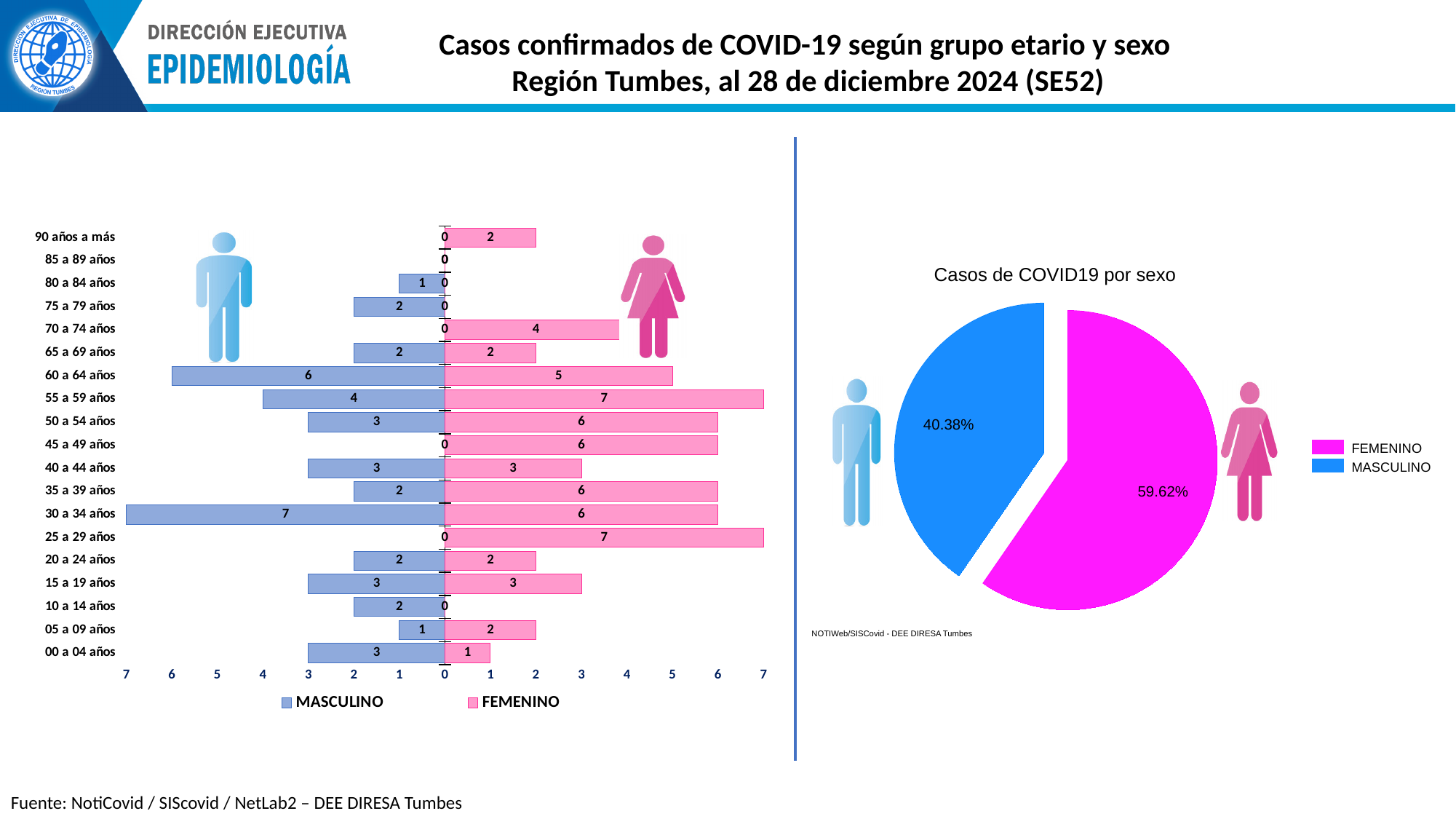
In the left bar chart, how many FEMENINO cases are in the 50 a 54 años group? 6 How many series does the legend of the left bar chart list? 2 In the left bar chart, what is the total of MASCULINO and FEMENINO cases in the 00 a 04 años group? 4 In the pie chart 'Casos de COVID19 por sexo', which slice is larger, FEMENINO or MASCULINO? FEMENINO How many age groups are shown in the left bar chart? 19 In the left bar chart, which is larger in the 60 a 64 años group, MASCULINO or FEMENINO? MASCULINO In the left bar chart, how many FEMENINO cases are in the 70 a 74 años group? 4 In the pie chart 'Casos de COVID19 por sexo', what share is FEMENINO? 59.62% In the left bar chart, which age group has the highest number of MASCULINO cases? 30 a 34 años What kind of chart is the chart titled 'Casos de COVID19 por sexo'? Pie chart In the left bar chart, what is the difference between FEMENINO and MASCULINO cases in the 55 a 59 años group? 3 In the left bar chart, how many MASCULINO cases are in the 30 a 34 años group? 7